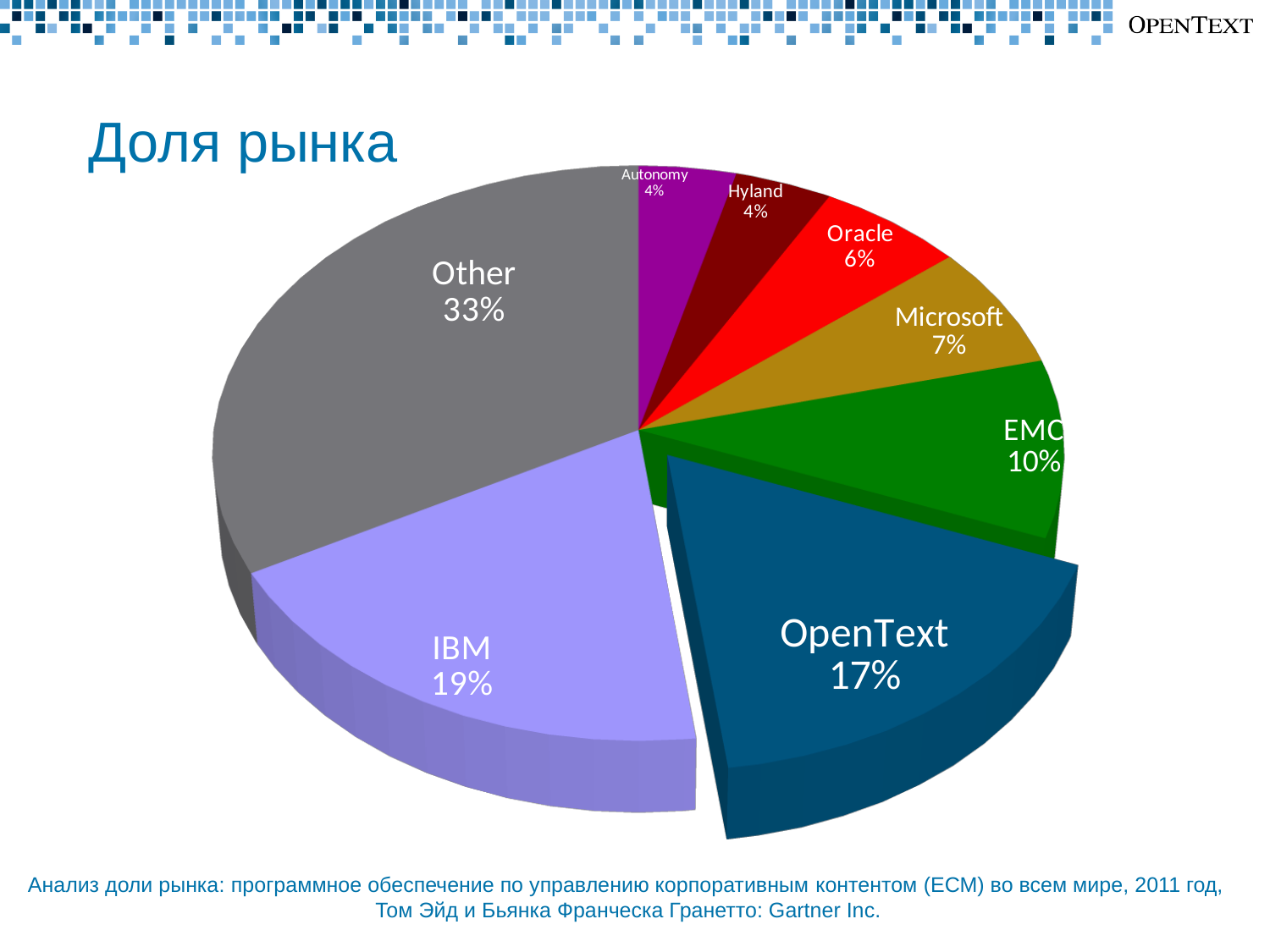
What is the market share shown for OpenText? 17% What kind of chart is shown on the slide? pie chart Which has a larger share, EMC or Microsoft? EMC What is the market share shown for IBM? 19% What is the market share shown for Oracle? 6% Which named vendor (excluding Other) has the largest share? IBM What is the title of the slide containing the chart? Доля рынка What is the difference in percentage points between IBM and OpenText? 2 What is the market share shown for EMC? 10% How many slices does the pie chart have? 8 Which slice of the pie is the largest? Other What is the market share shown for Microsoft? 7%